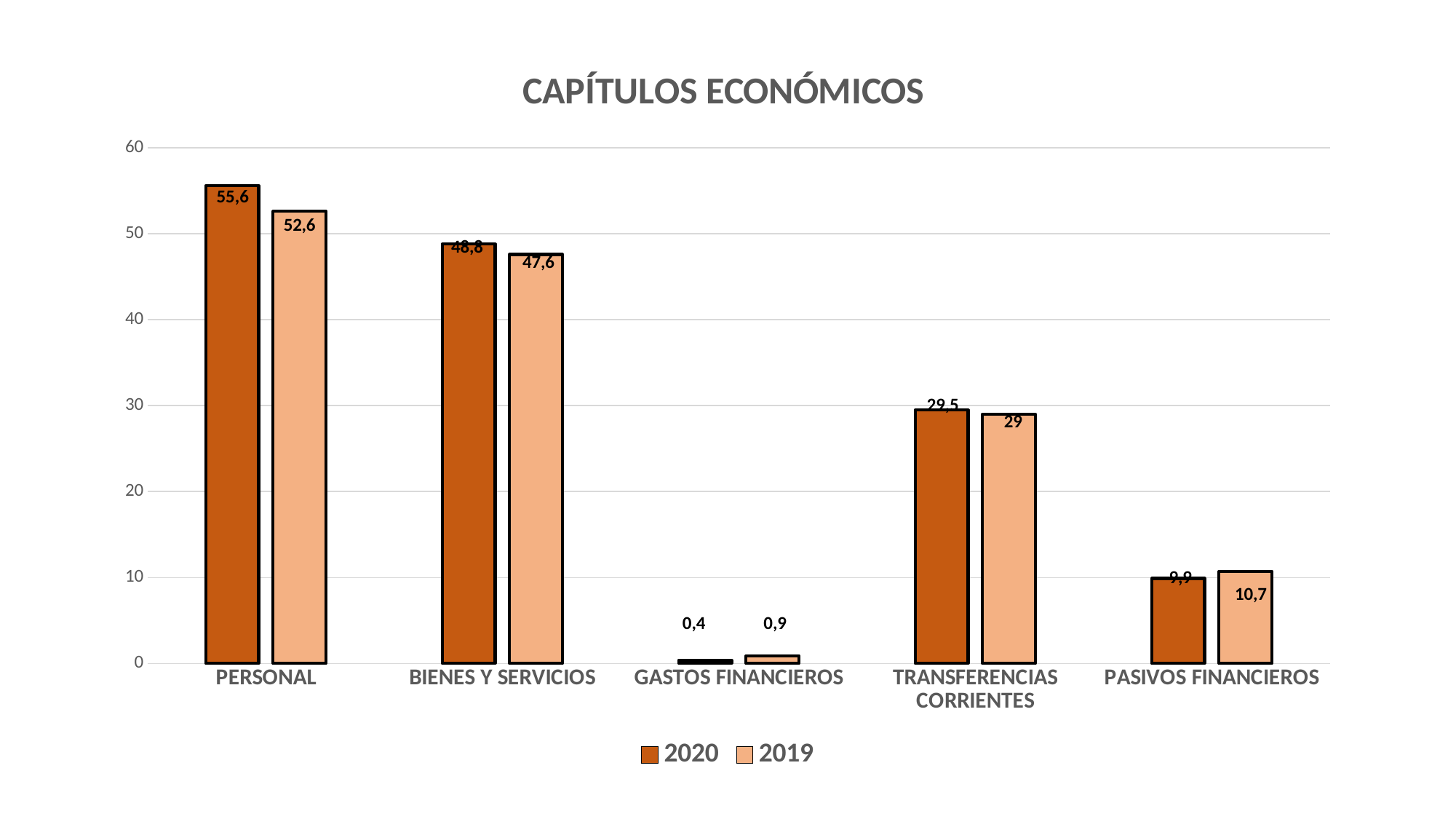
What is the 2020 value for PERSONAL? 55,6 For PASIVOS FINANCIEROS, which year has the larger value, 2020 or 2019? 2019 What kind of chart is shown on the slide? Bar chart What is the 2019 value for BIENES Y SERVICIOS? 47,6 What is the 2020 value for GASTOS FINANCIEROS? 0,4 Is the 2019 value for PERSONAL greater or less than 50? greater What is the 2019 value for TRANSFERENCIAS CORRIENTES? 29 How many categories are shown on the x axis? 5 What is the difference between the 2020 and 2019 values for PERSONAL? 3 Which category has the lowest 2019 value? GASTOS FINANCIEROS How many series does the legend list? 2 Which category has the highest 2020 value? PERSONAL